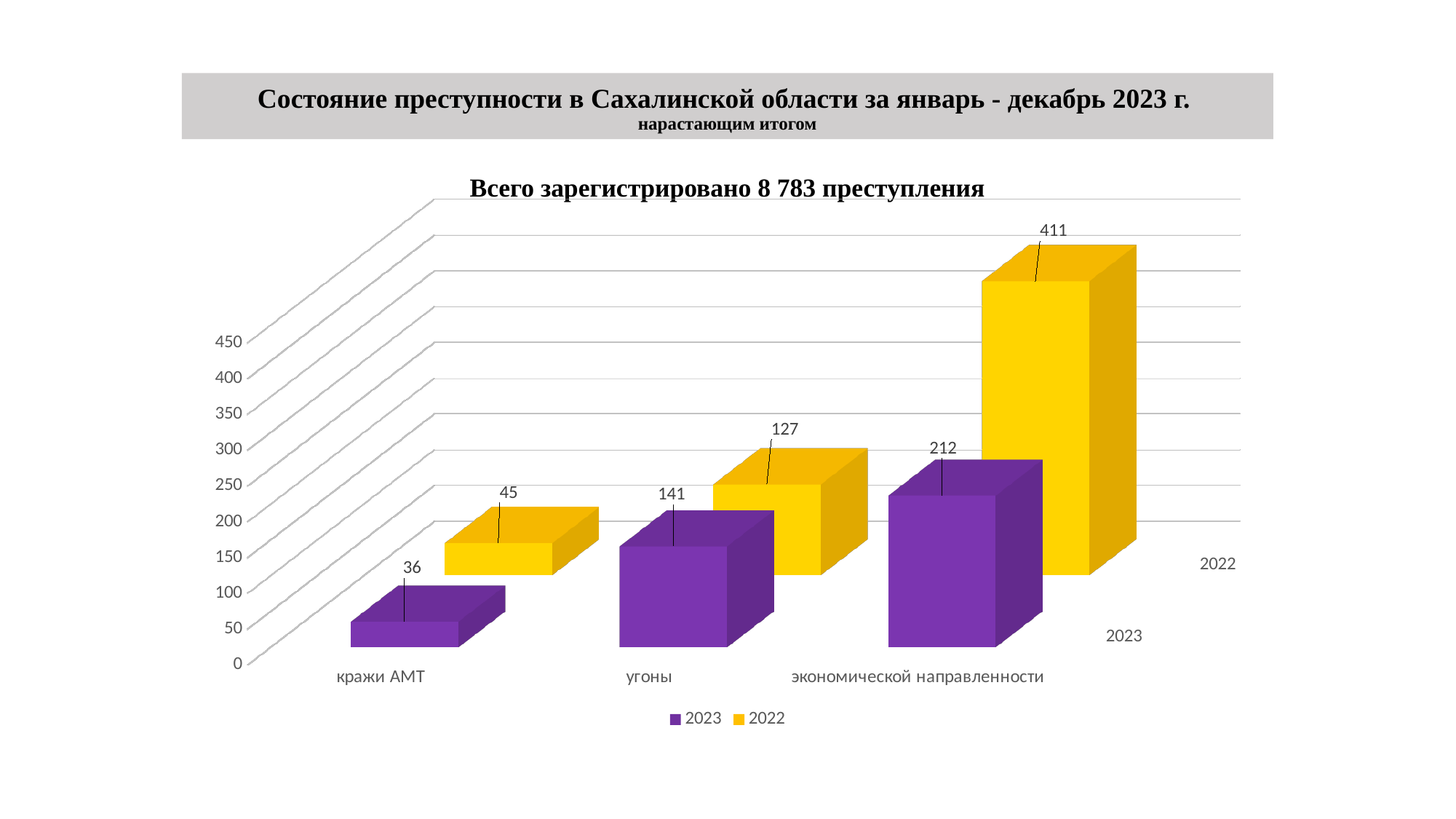
How many series does the legend list? 2 What is the value for кражи АМТ in the 2023 series? 36 What is the title of the chart? Всего зарегистрировано 8 783 преступления What is the difference between the 2022 and 2023 values for экономической направленности? 199 Which category has the highest value in the 2023 series? экономической направленности How many categories are shown on the x axis? 3 Do the values in the 2022 series rise or fall from кражи АМТ to экономической направленности? rise What kind of chart is shown on the slide? bar chart For угоны, which series has the larger value, 2023 or 2022? 2023 What is the value for угоны in the 2022 series? 127 Which category has the lowest value in the 2022 series? кражи АМТ What is the value for экономической направленности in the 2022 series? 411